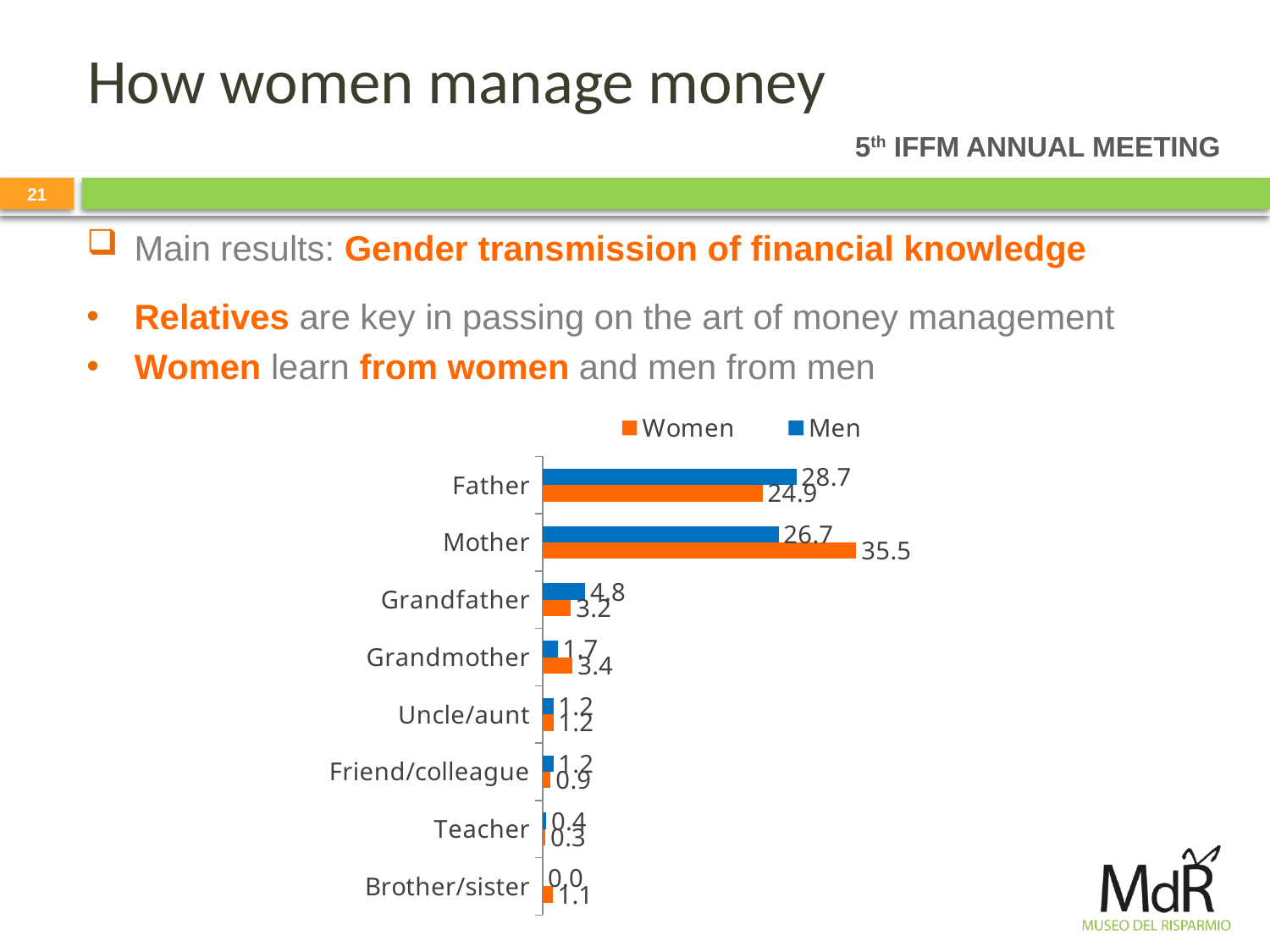
What is the value for Women for Mother? 35.5 What is the difference between the Women and Men values for Mother? 8.8 What is the value for Men for Brother/sister? 0.0 What is the value for Men for Father? 28.7 For Father, which series has the larger value, Women or Men? Men What is the value for Women for Grandmother? 3.4 Which category has the highest value for Women? Mother How many series does the legend list? 2 Which category has the highest value for Men? Father Which colour represents the Women series? orange How many categories are shown on the chart? 8 What kind of chart is shown on the slide? bar chart